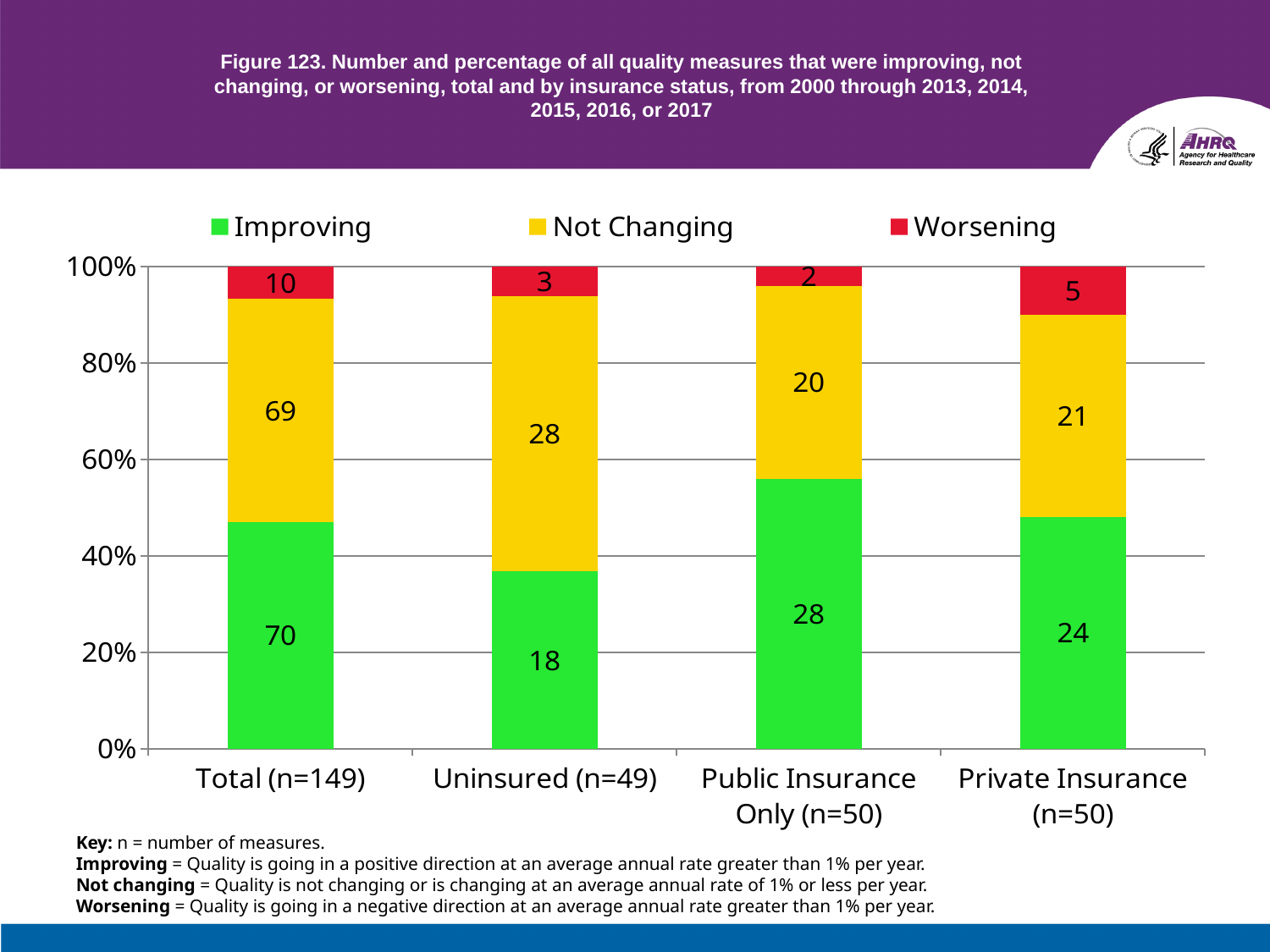
How many quality measures were not changing for Public Insurance Only (n=50)? 20 Which category has the highest number of improving measures? Total (n=149) What kind of chart is shown on the slide? Stacked bar chart Which category has the lowest number of worsening measures? Public Insurance Only (n=50) How many quality measures were worsening for Private Insurance (n=50)? 5 What is the total number of measures in the Private Insurance (n=50) bar, summing improving, not changing, and worsening? 50 Is the improving share of the Public Insurance Only (n=50) bar greater or less than 40%? greater How many series does the legend list? 3 What is the difference between the number of improving measures for Public Insurance Only (n=50) and Private Insurance (n=50)? 4 How many quality measures were improving for Uninsured (n=49)? 18 Which is larger for Uninsured (n=49): the number of improving measures or the number of not changing measures? Not Changing How many insurance status categories are shown on the x axis? 4